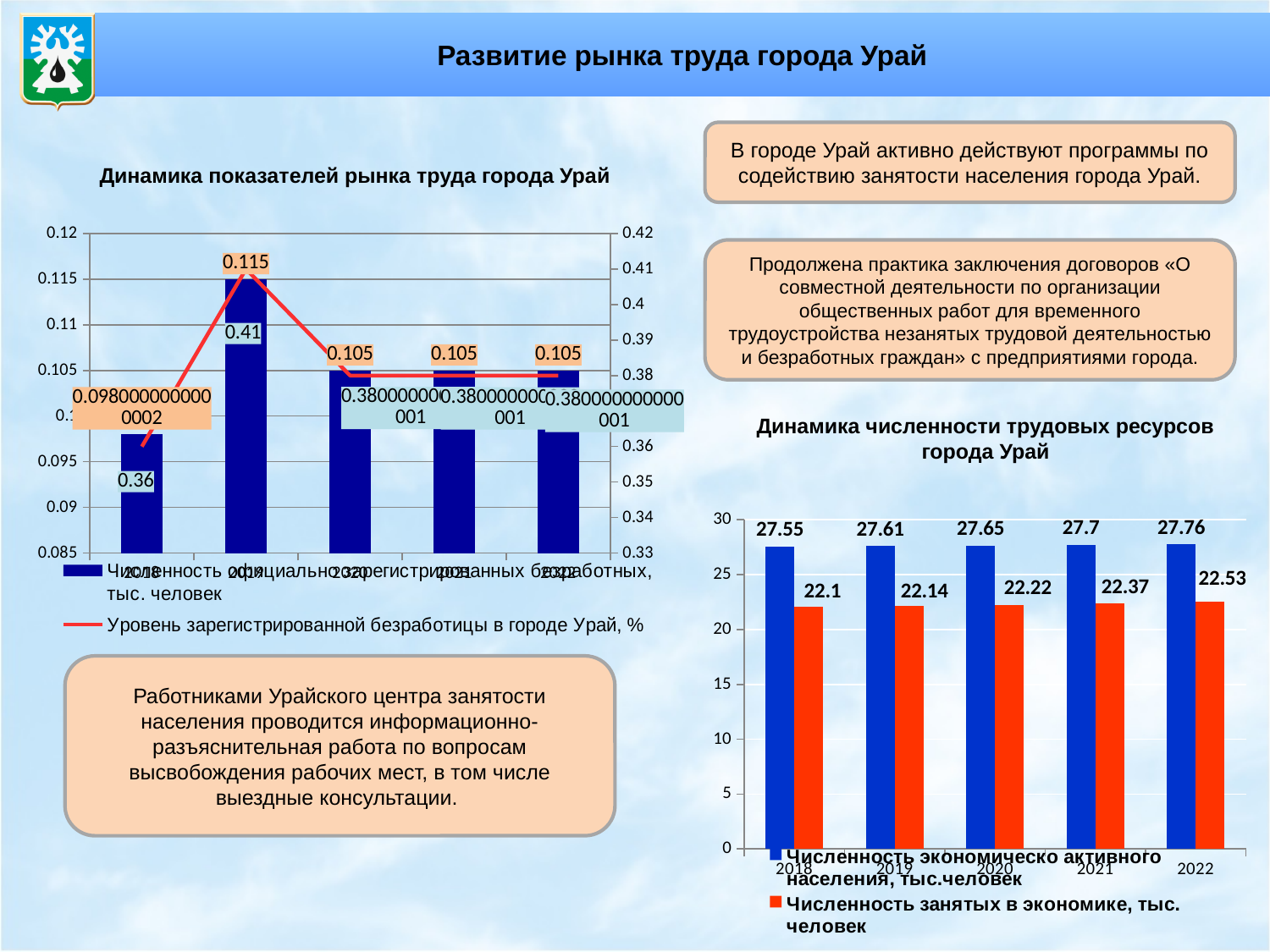
In the chart 'Динамика показателей рынка труда города Урай', in which year is the number of officially registered unemployed highest? 2019 What kind of chart is 'Динамика численности трудовых ресурсов города Урай'? bar chart In the chart 'Динамика численности трудовых ресурсов города Урай', in which year is 'Численность экономическо активного населения, тыс.человек' lowest? 2018 In the chart 'Динамика показателей рынка труда города Урай', what is the value of the bar for 2019 (Численность официально зарегистрированных безработных, тыс. человек)? 0.115 How many series does the legend of the chart 'Динамика численности трудовых ресурсов города Урай' list? 2 In the chart 'Динамика численности трудовых ресурсов города Урай', does 'Численность занятых в экономике, тыс. человек' rise or fall from 2018 to 2022? rise In the chart 'Динамика численности трудовых ресурсов города Урай', what is the value of 'Численность экономическо активного населения, тыс.человек' for 2022? 27.76 In the chart 'Динамика показателей рынка труда города Урай', what is the value of 'Уровень зарегистрированной безработицы в городе Урай, %' for 2019? 0.41 In the chart 'Динамика численности трудовых ресурсов города Урай', what is the value of 'Численность занятых в экономике, тыс. человек' for 2018? 22.1 How many years are shown on the x axis of the chart 'Динамика численности трудовых ресурсов города Урай'? 5 In the chart 'Динамика численности трудовых ресурсов города Урай', in which year is 'Численность занятых в экономике, тыс. человек' highest? 2022 In the chart 'Динамика численности трудовых ресурсов города Урай', what is the difference between the economically active population and the employed population in 2022? 5.23